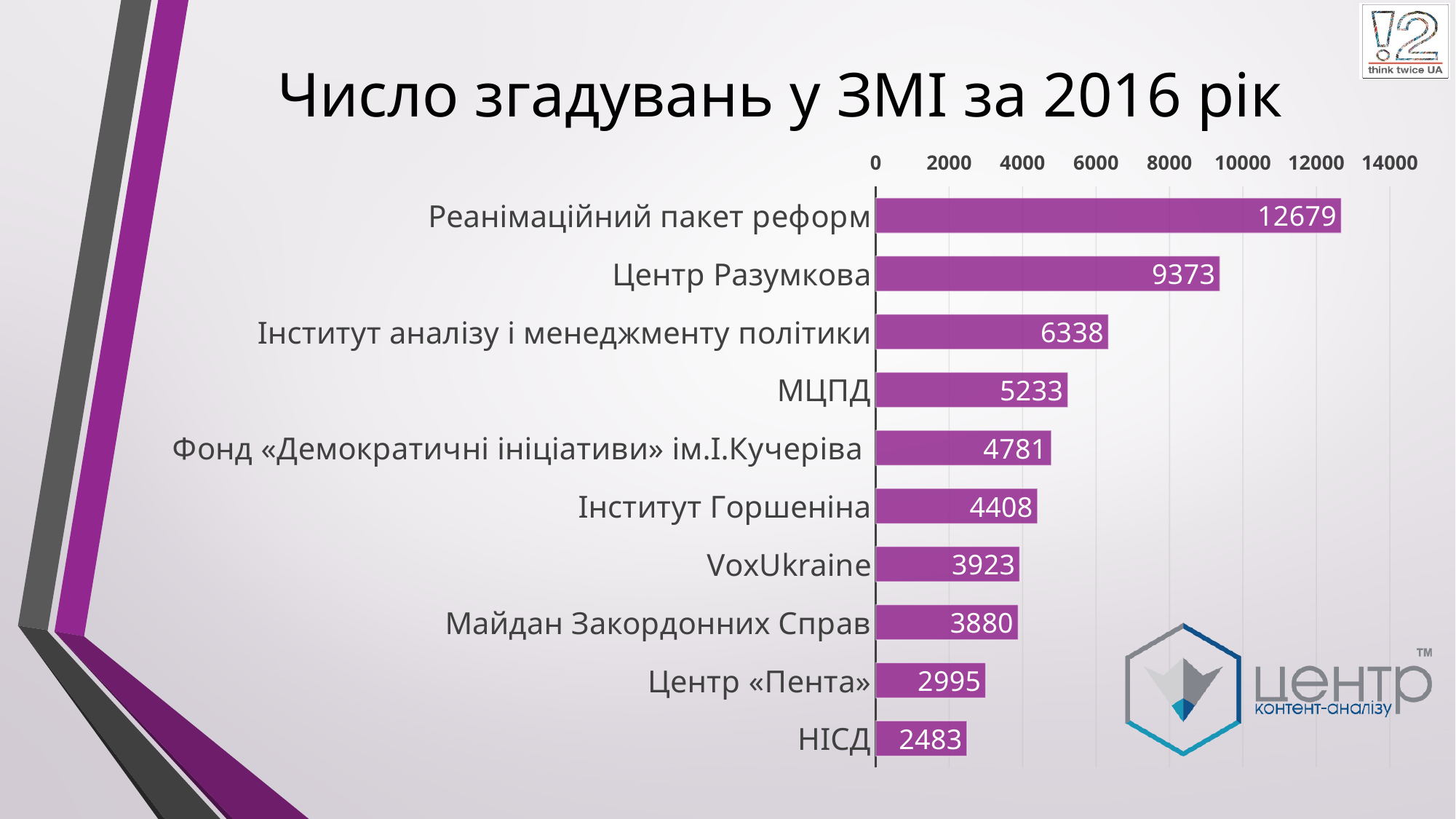
What is the difference between the values for МЦПД and Інститут Горшеніна? 825 What is the value for VoxUkraine? 3923 Which category has the lowest value? НІСД How many categories are shown in the chart? 10 What kind of chart is shown on the slide? bar chart What is the difference between the values for Реанімаційний пакет реформ and Центр Разумкова? 3306 Which category has the highest value? Реанімаційний пакет реформ Which is larger: the value for Інститут аналізу і менеджменту політики or the value for Фонд «Демократичні ініціативи» ім.І.Кучеріва? Інститут аналізу і менеджменту політики What is the value for Реанімаційний пакет реформ? 12679 What is the value for Центр Разумкова? 9373 What is the value for НІСД? 2483 Is the value for Центр «Пента» greater or less than 4000? less